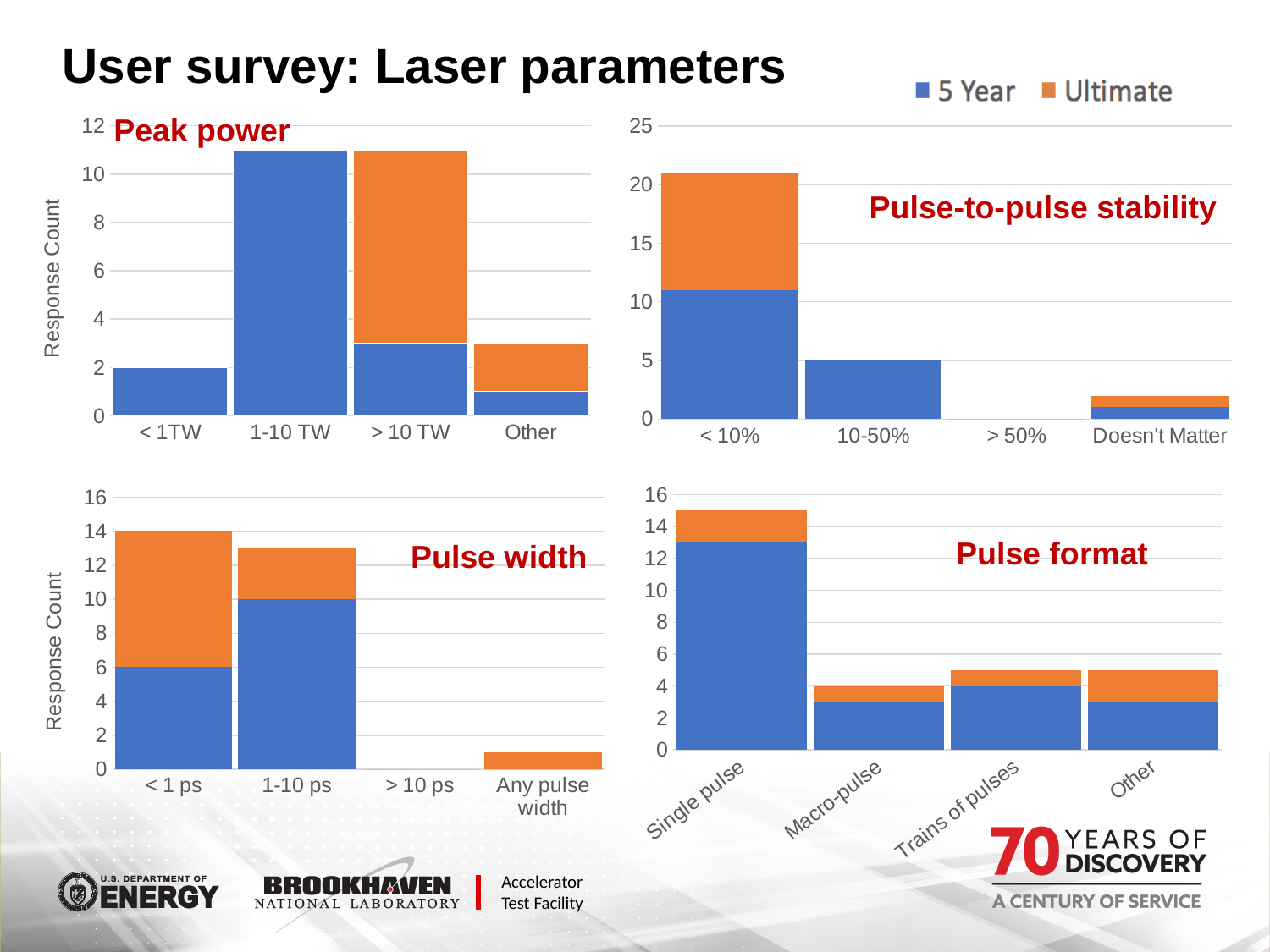
In the Pulse format chart, is the total response count for Single pulse greater or less than 10? greater In the Pulse width chart, what is the 5 Year response count for 1-10 ps? 10 In the Peak power chart, which has the larger 5 Year response count, 1-10 TW or > 10 TW? 1-10 TW How many categories are shown on the x axis of the Pulse format chart? 4 What kind of chart is the Peak power chart? bar chart In the Pulse-to-pulse stability chart, what is the 5 Year response count for 10-50%? 5 How many series does the legend list? 2 In the Pulse format chart, which category has the highest total response count? Single pulse In the Pulse-to-pulse stability chart, which category has the highest total response count? < 10% In the Peak power chart, which category has the lowest total response count? < 1TW In the Pulse width chart, what is the total response count for < 1 ps? 14 Which colour represents the Ultimate series in the legend? orange